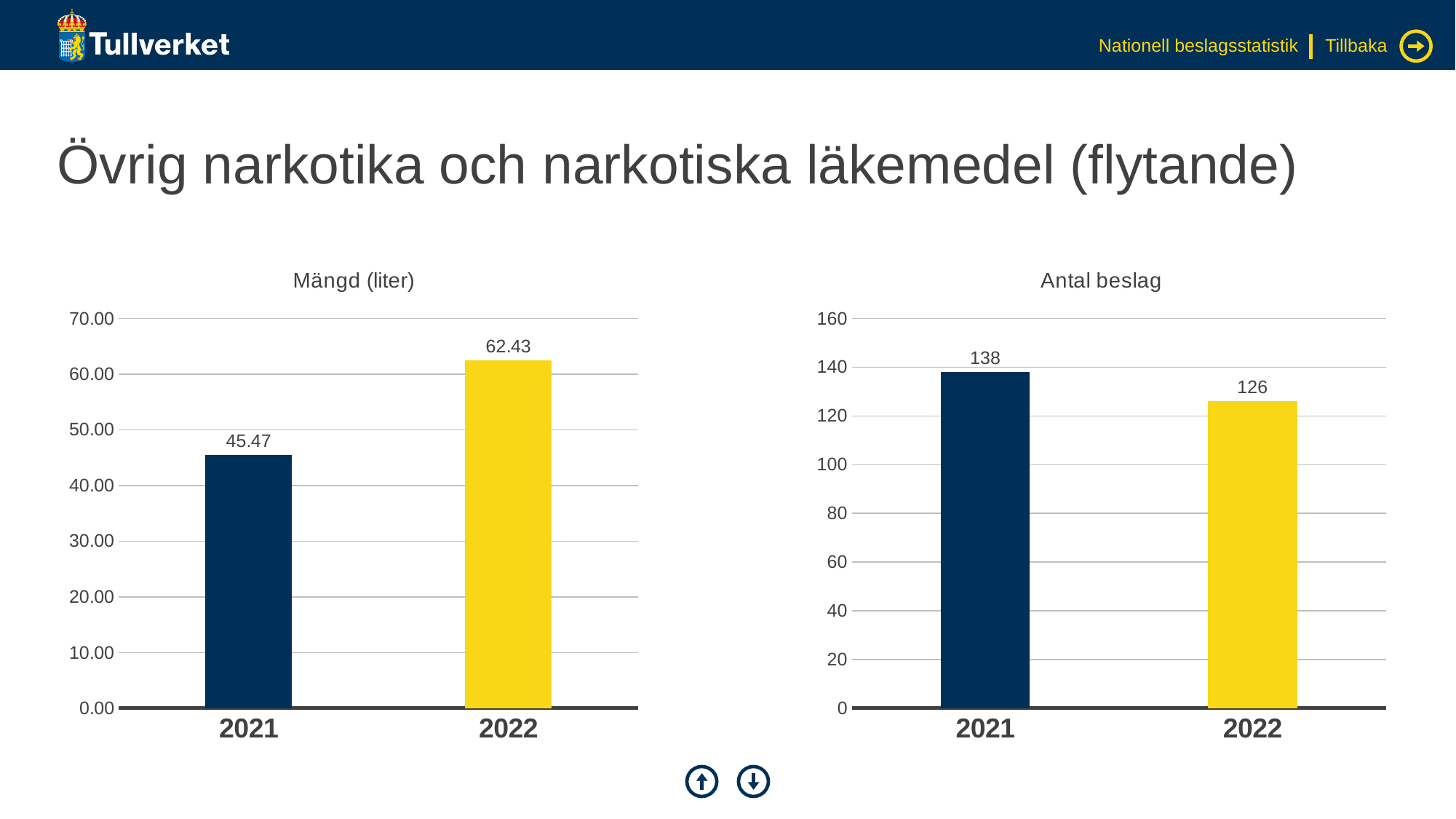
In the 'Mängd (liter)' chart, what is the value for 2022? 62.43 In the 'Mängd (liter)' chart, do the values rise or fall from 2021 to 2022? rise In the 'Mängd (liter)' chart, what is the difference between the 2022 and 2021 values? 16.96 In the 'Antal beslag' chart, which is larger, the value for 2021 or 2022? 2021 In the 'Mängd (liter)' chart, what is the value for 2021? 45.47 In the 'Antal beslag' chart, what is the value for 2022? 126 What kind of chart is the 'Mängd (liter)' chart? bar chart In the 'Antal beslag' chart, what is the difference between the 2021 and 2022 values? 12 In the 'Antal beslag' chart, what is the value for 2021? 138 How many categories are shown on the x axis of the 'Antal beslag' chart? 2 In the 'Mängd (liter)' chart, which year has the highest value? 2022 In the 'Antal beslag' chart, which year has the lowest value? 2022